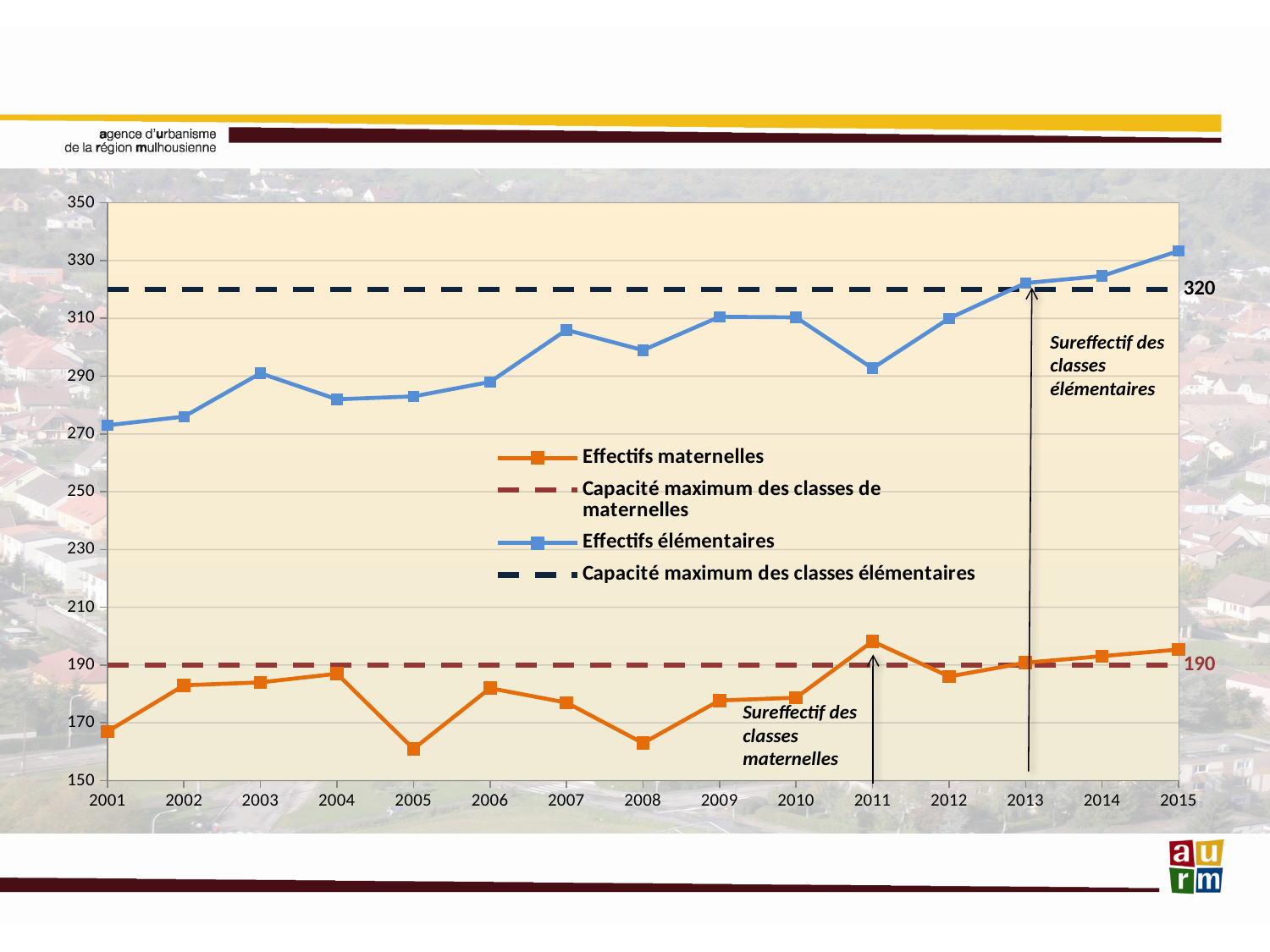
What is the value of the 'Capacité maximum des classes de maternelles' line? 190 In which year is 'Effectifs élémentaires' highest? 2015 Which year has the larger value for 'Effectifs élémentaires', 2010 or 2011? 2010 How many years are shown on the x axis? 15 Which year does the arrow labelled 'Sureffectif des classes maternelles' point to? 2011 What kind of chart is shown on the slide? line chart Is the value for 'Effectifs élémentaires' in 2001 greater or less than 290? less How many series does the legend list? 4 Is the value for 'Effectifs élémentaires' in 2015 greater or less than 320? greater Is the value for 'Effectifs maternelles' in 2005 greater or less than 170? less What is the difference between the maximum capacity of the elementary classes and the maximum capacity of the maternelle classes? 130 What is the value of the 'Capacité maximum des classes élémentaires' line? 320